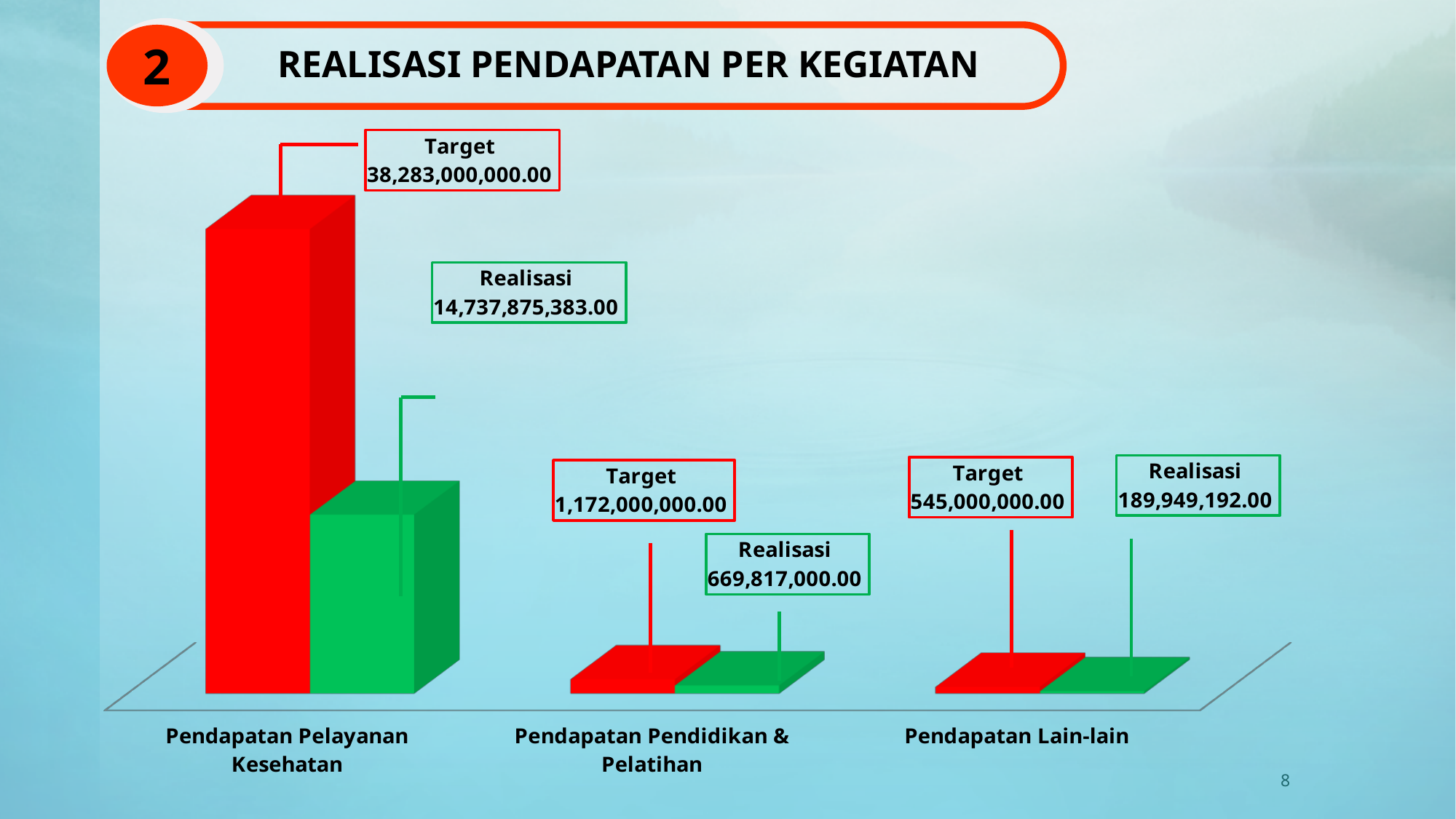
What is the Realisasi value for Pendapatan Pendidikan & Pelatihan? 669,817,000.00 Which category has the lowest Realisasi value? Pendapatan Lain-lain Which category has the highest Target value? Pendapatan Pelayanan Kesehatan What is the difference between the Target and Realisasi values for Pendapatan Lain-lain? 355,050,808.00 What is the Target value for Pendapatan Pendidikan & Pelatihan? 1,172,000,000.00 What is the Target value for Pendapatan Pelayanan Kesehatan? 38,283,000,000.00 What is the Realisasi value for Pendapatan Lain-lain? 189,949,192.00 Which is larger for Pendapatan Pendidikan & Pelatihan, the Target or the Realisasi? Target How many categories are shown on the x axis of the chart? 3 What is the Target value for Pendapatan Lain-lain? 545,000,000.00 What kind of chart is shown on the slide? Bar chart What is the Realisasi value for Pendapatan Pelayanan Kesehatan? 14,737,875,383.00